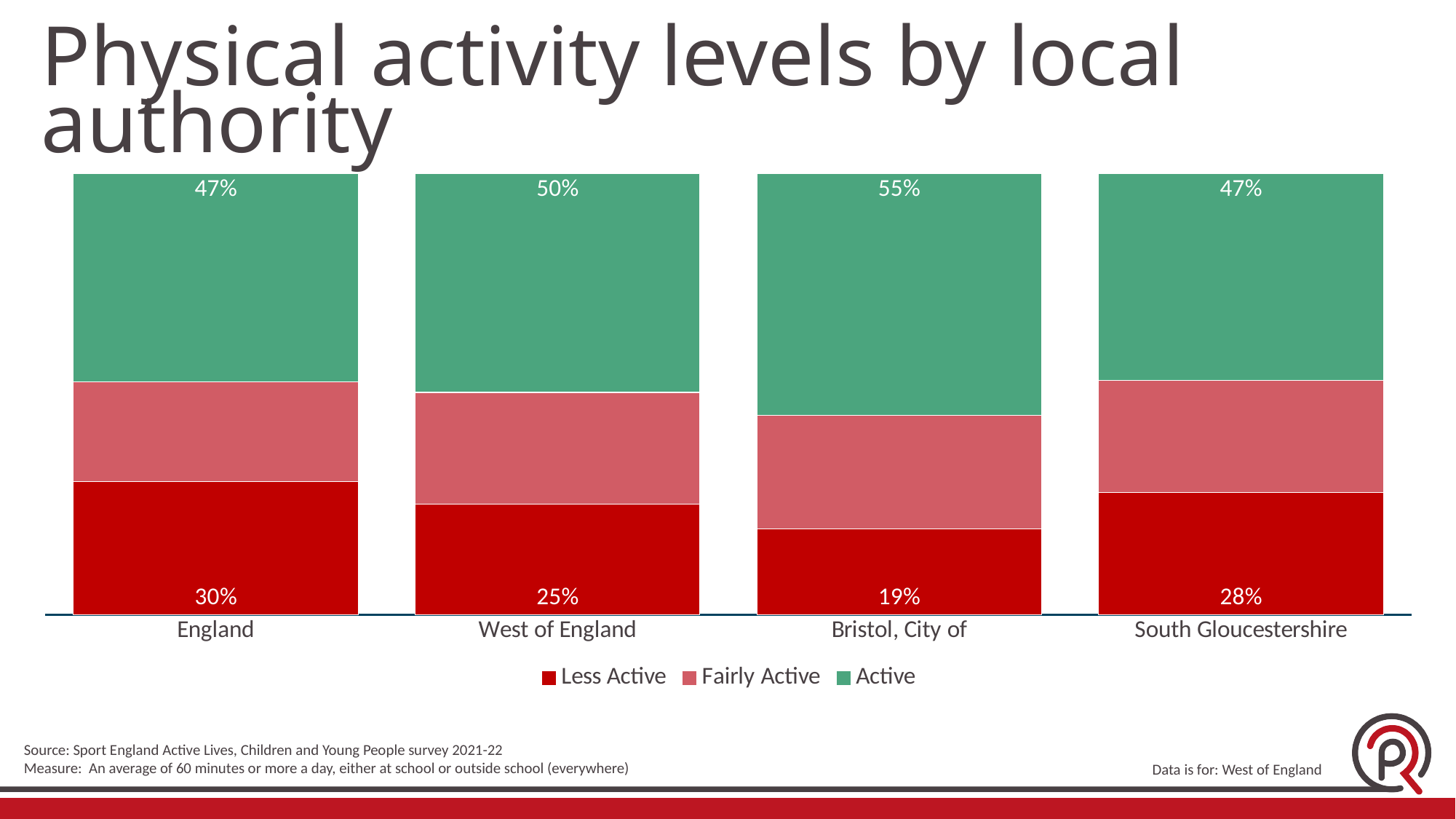
How many series does the legend list? 3 What is the difference between the Active percentage for Bristol, City of and for England? 8% What is the Less Active percentage for England? 30% Is the Active percentage higher for West of England or for South Gloucestershire? West of England What is the Active percentage for South Gloucestershire? 47% Which area has the highest Less Active percentage? England Which local authority has the highest Active percentage? Bristol, City of What is the difference between the Less Active percentage for England and for Bristol, City of? 11% What is the Less Active percentage for West of England? 25% Which area has the lowest Less Active percentage? Bristol, City of How many local authorities or areas are shown on the x axis? 4 What is the Active percentage for Bristol, City of? 55%